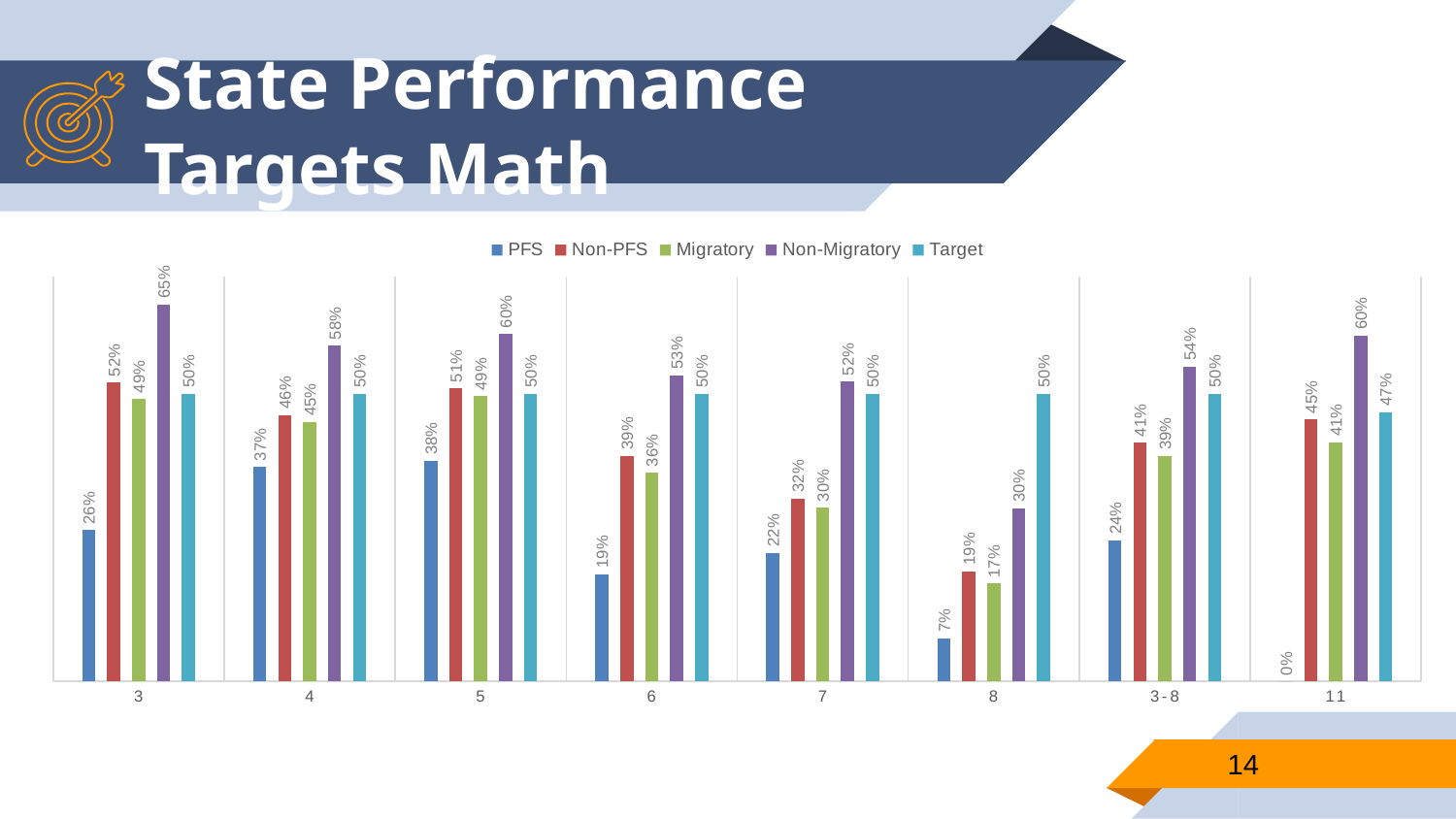
Which is larger for grade 7: the Non-PFS value or the Migratory value? Non-PFS Which category has the lowest PFS value? 11 What is the Migratory value for the 3-8 category? 39% What kind of chart is shown on the slide? Bar chart What is the Target value for grade 11? 47% What is the Non-Migratory value for grade 3? 65% What is the difference between the Non-PFS and PFS values for grade 6? 20% How many series does the legend list? 5 Which category has the highest Non-Migratory value? 3 What is the PFS value for grade 8? 7% What is the title of the slide? State Performance Targets Math How many categories are shown on the x axis? 8